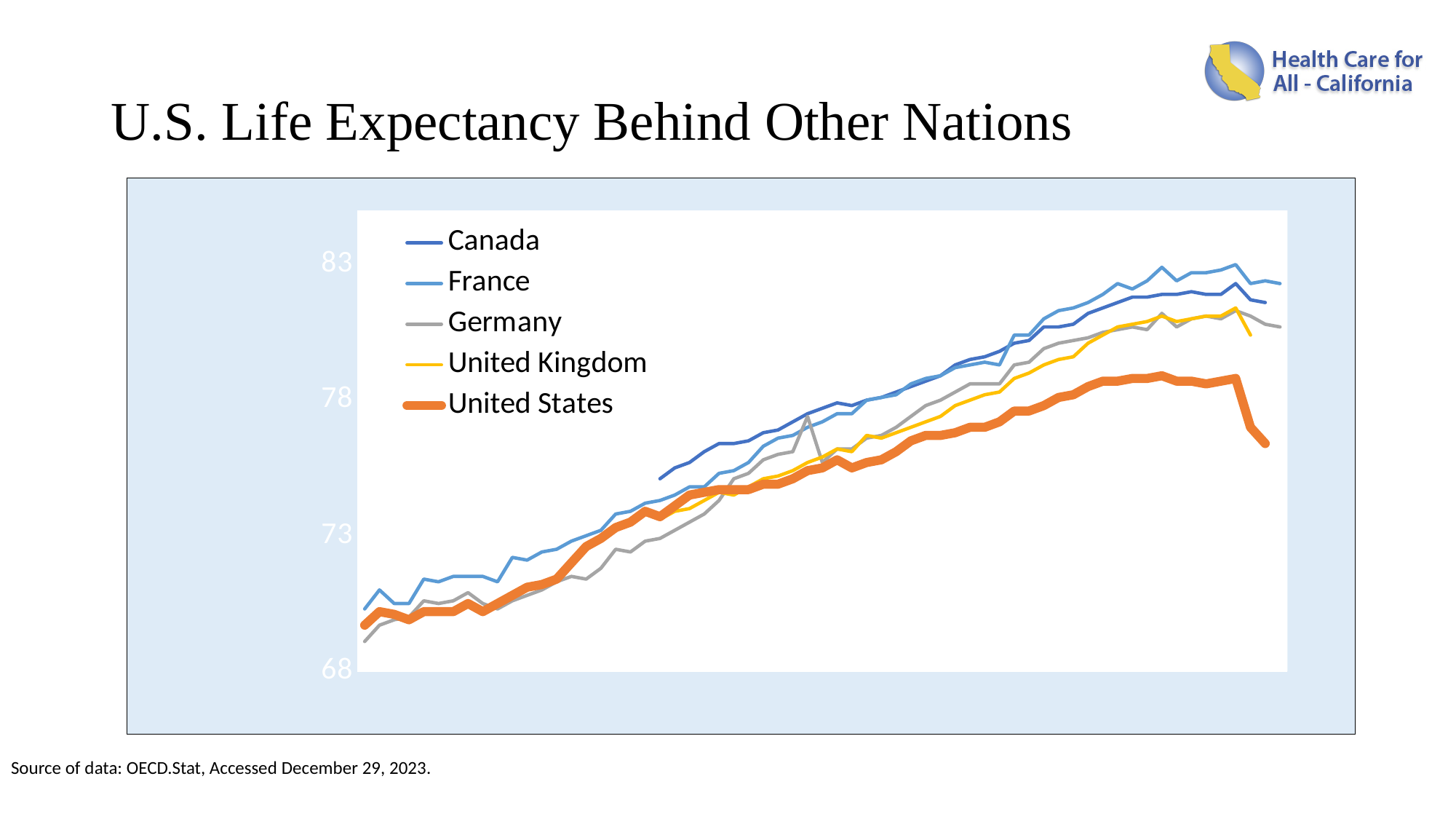
What kind of chart is shown on the slide? line chart Over the whole chart, do the life expectancy lines generally rise or fall from left to right? rise Is the value of the United States line at the left end of the chart greater or less than 73? less What is the title of the slide containing the chart? U.S. Life Expectancy Behind Other Nations At the far right end of the chart, does the United States line rise or fall? fall Which series is lowest at the right end of the chart? United States Is the final value of the United States line greater or less than 78? less At the right end of the chart, which is higher, Canada or United States? Canada Which series is highest at the right end of the chart? France How many series does the chart's legend list? 5 Which series is drawn with the thickest line in the chart? United States Is the highest point of the France line greater or less than 78? greater